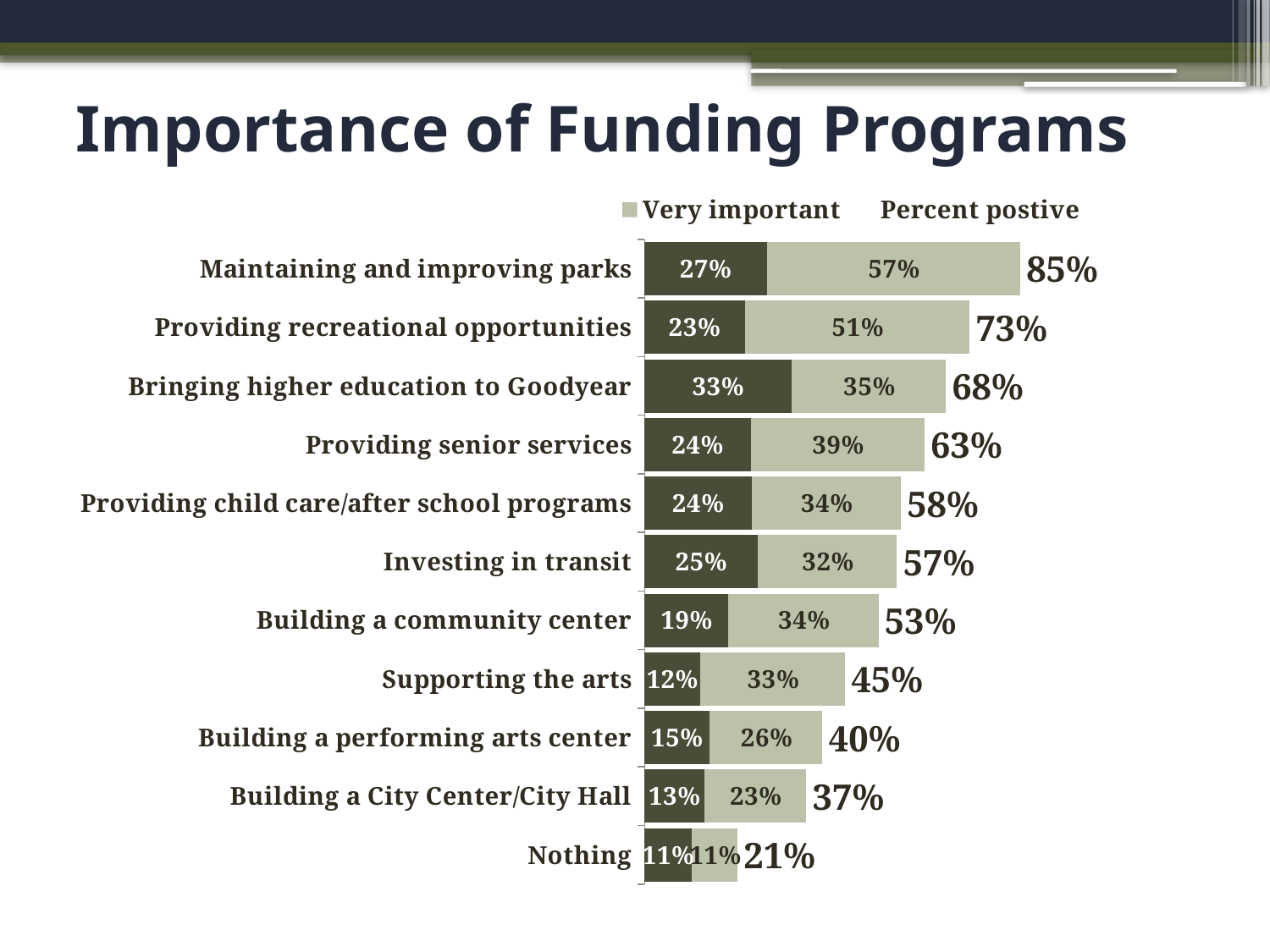
What type of chart is shown on the slide? Stacked bar chart What is the difference between the 'Percent postive' values for Maintaining and improving parks and Providing recreational opportunities? 12% What overall percentage is printed at the end of the bar for Supporting the arts? 45% Which category has the highest 'Very important' value? Maintaining and improving parks What is the 'Very important' value for Bringing higher education to Goodyear? 35% What is the difference between the 'Very important' values for Building a performing arts center and Building a City Center/City Hall? 3% Which category has the lowest overall percentage printed at the end of its bar? Nothing Which legend entry is shown with the darker colour? Very important How many categories are plotted in the chart? 11 What is the 'Percent postive' value for Providing senior services? 63% How many series does the legend list? 2 Which is larger, the 'Very important' value for Investing in transit or for Building a community center? Building a community center